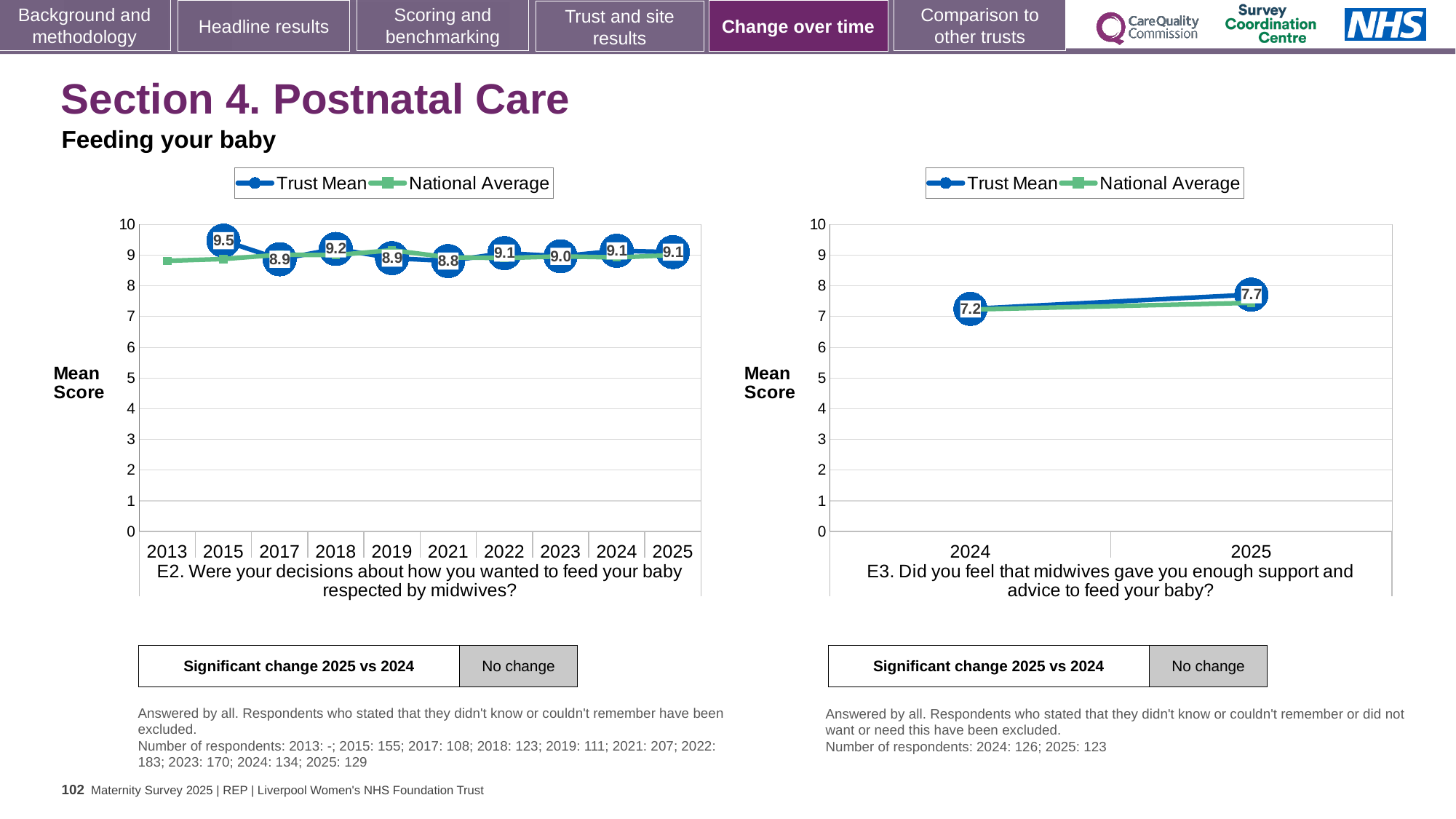
What kind of chart is the right chart (E3)? Line chart On the left chart (E2), is the National Average for 2013 greater or less than 8? greater On the left chart (E2), which year has the highest Trust Mean? 2015 On the right chart (E3), what is the difference between the Trust Mean for 2025 and 2024? 0.5 How many years are shown on the x axis of the left chart (E2)? 10 How many series does the legend of the right chart (E3) list? 2 On the right chart (E3), what is the Trust Mean for 2024? 7.2 On the left chart (E2), what is the Trust Mean for 2015? 9.5 On the right chart (E3), does the Trust Mean rise or fall from 2024 to 2025? Rise On the left chart (E2), what is the Trust Mean for 2021? 8.8 On the left chart (E2), which year has the lowest Trust Mean? 2021 On the left chart (E2), is the Trust Mean higher in 2018 or in 2019? 2018